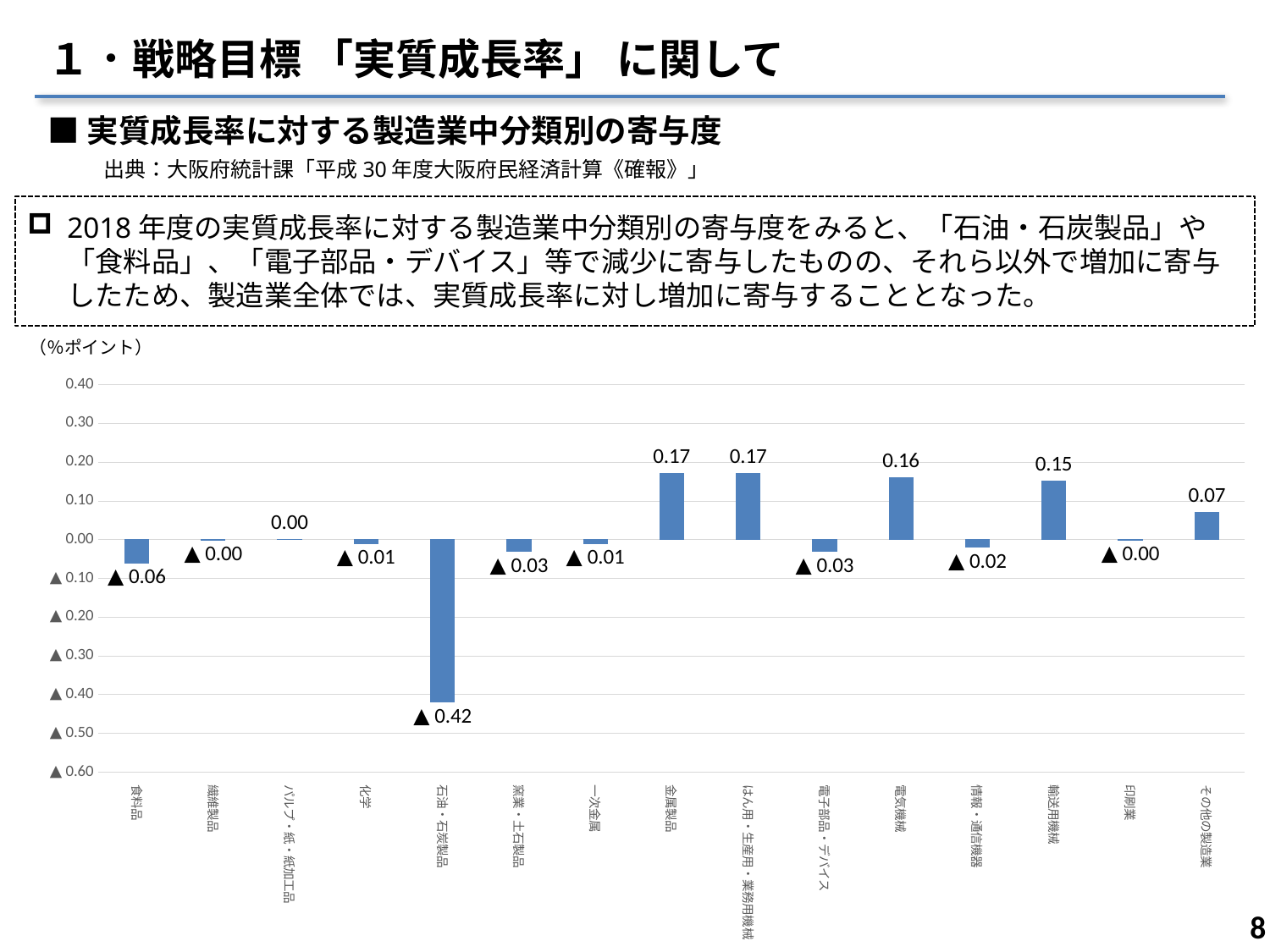
What is the value for 輸送用機械? 0.15 What is the difference between the values for 金属製品 and 輸送用機械? 0.02 Which is larger, the value for 電気機械 or the value for その他の製造業? 電気機械 What is the value for 石油・石炭製品? ▲ 0.42 What is the value for 食料品? ▲ 0.06 What is the value for 電気機械? 0.16 What kind of chart is shown on the slide? bar chart What unit is indicated above the chart? %ポイント Which category has the lowest value? 石油・石炭製品 Is the value for 石油・石炭製品 greater or less than ▲ 0.30? less What is the value for その他の製造業? 0.07 How many categories are shown on the x axis? 15